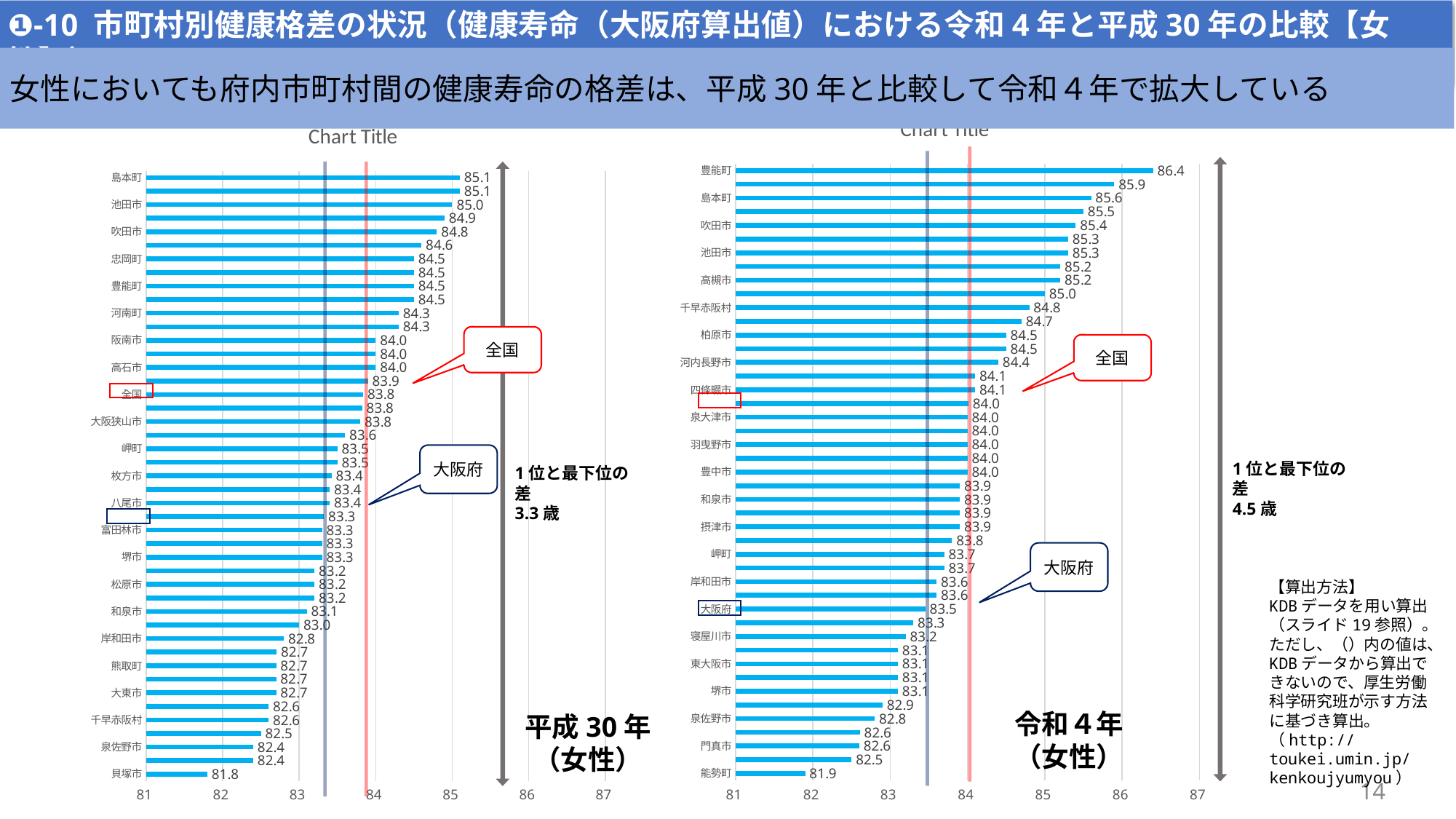
In the right chart (令和4年（女性）), which category has the highest value? 豊能町 In the right chart (令和4年（女性）), what is the difference between the highest value (豊能町, 86.4) and the lowest value (能勢町, 81.9)? 4.5 In the left chart (平成30年（女性）), which category has the lowest value? 貝塚市 Which is larger: the value for 吹田市 in the left chart (平成30年) or the value for 吹田市 in the right chart (令和4年)? 令和4年 (85.4) What kind of chart is used on this slide? Bar chart In the left chart (平成30年（女性）), what is the value for 島本町? 85.1 In the left chart (平成30年（女性）), what is the difference between the highest value (85.1) and the lowest value (81.8)? 3.3 In the right chart (令和4年（女性）), is the value for 門真市 greater or less than 83? less In the right chart (令和4年（女性）), what is the value for 千早赤阪村? 84.8 In the left chart (平成30年（女性）), what is the value for 貝塚市? 81.8 In the right chart (令和4年（女性）), what is the value for 大阪府? 83.5 In the right chart (令和4年（女性）), what is the value for 能勢町? 81.9